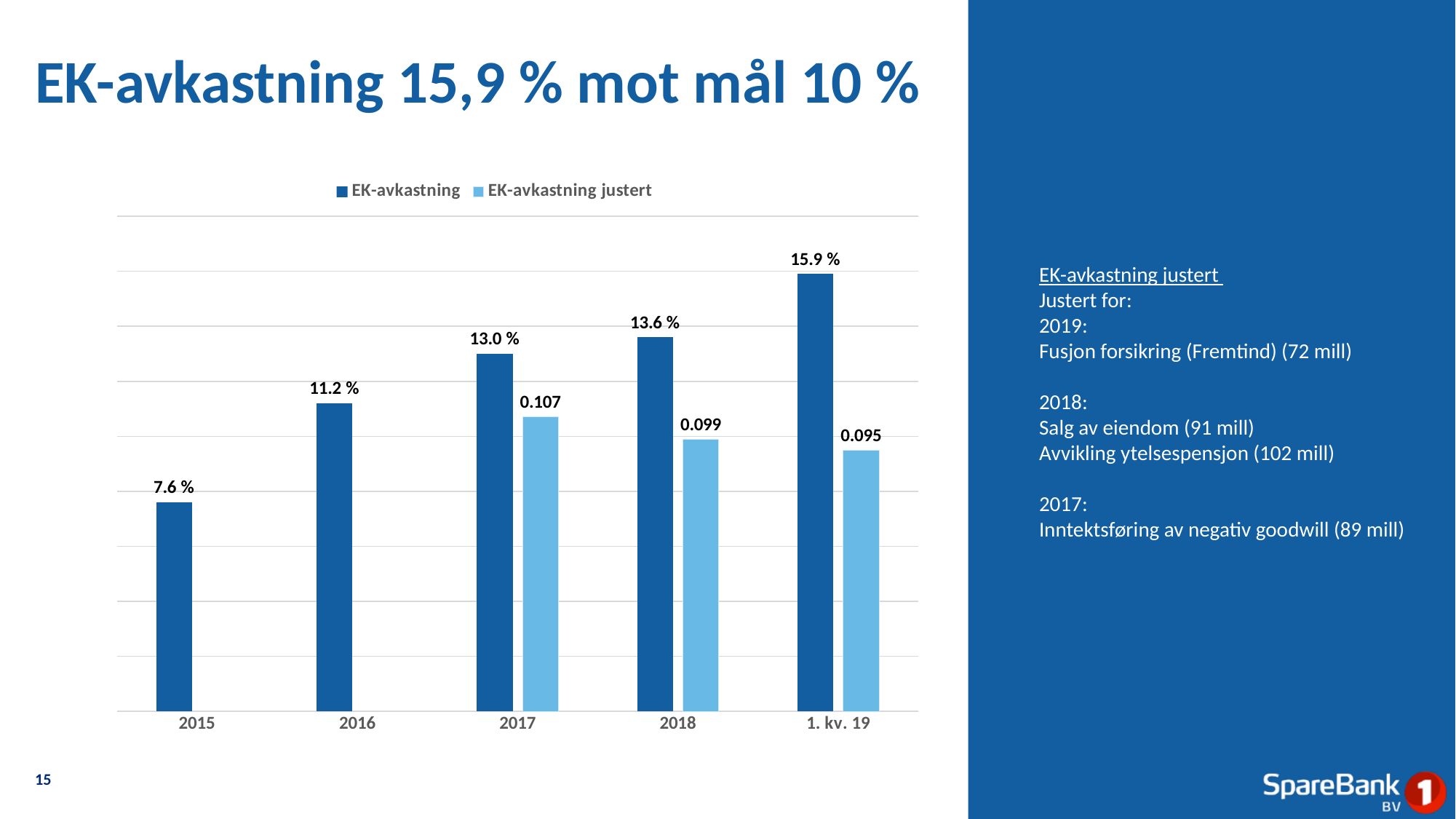
How many series does the legend list? 2 How many categories are shown on the x axis? 5 What is the EK-avkastning justert value for 2018? 0.099 What is the EK-avkastning value for 1. kv. 19? 15.9 % Which category has the highest EK-avkastning value? 1. kv. 19 Which is larger, the EK-avkastning value for 2017 or for 2018? 2018 What is the difference between the EK-avkastning justert values for 2017 and 1. kv. 19? 0.012 What is the EK-avkastning justert value for 2017? 0.107 What is the difference between the EK-avkastning values for 2016 and 2015? 3.6 percentage points What kind of chart is shown on the slide? Bar chart What is the EK-avkastning value for 2015? 7.6 % Which category has the lowest EK-avkastning value? 2015